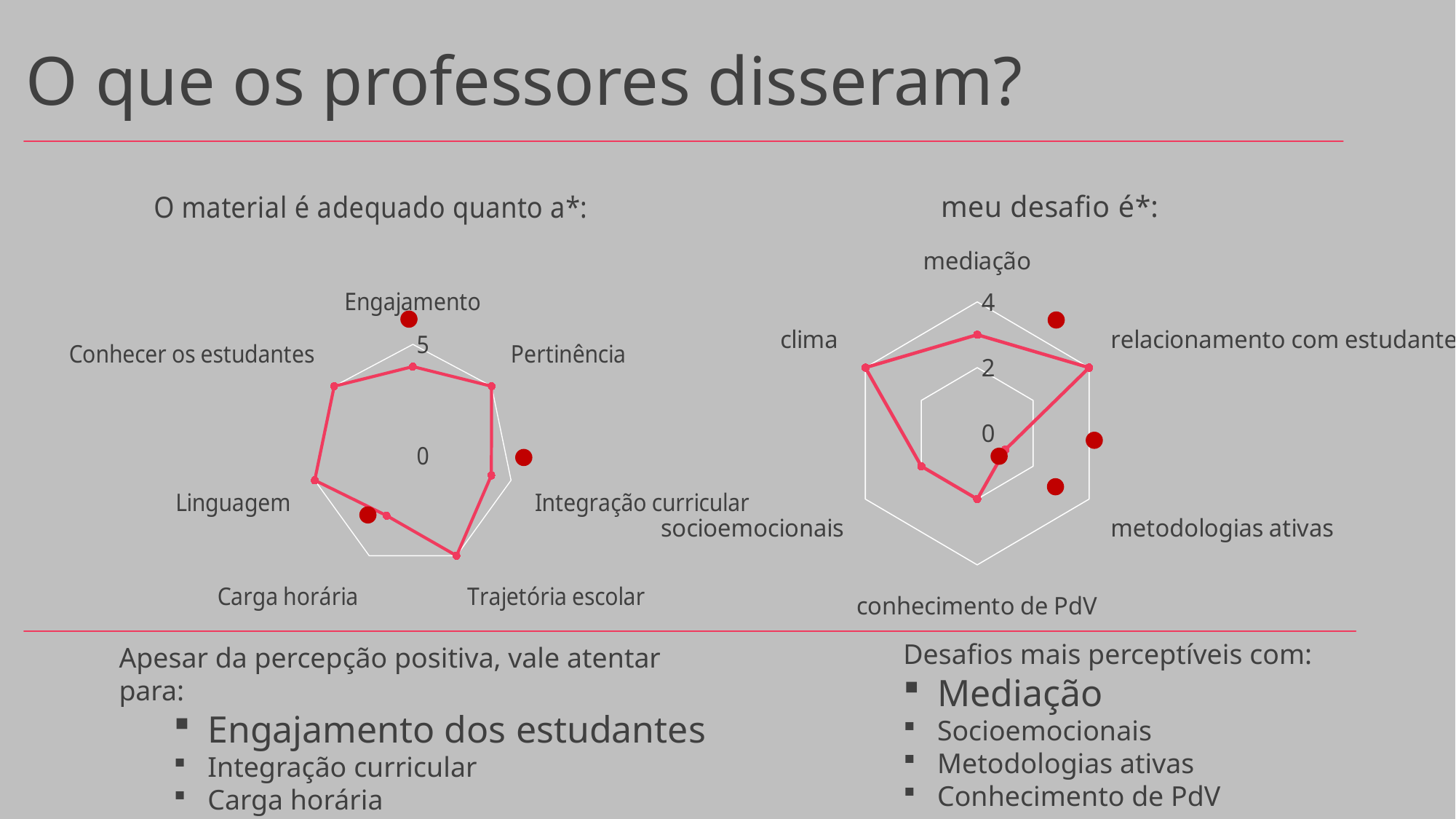
What type of chart is the right chart titled "meu desafio é*:"? radar chart On the right chart "meu desafio é*:", is the value for mediação greater or less than 2? greater How many categories are plotted on the right chart "meu desafio é*:"? 6 On the right chart "meu desafio é*:", which is larger, the value for clima or the value for conhecimento de PdV? clima On the right chart "meu desafio é*:", which category has the lowest value? metodologias ativas What type of chart is the left chart titled "O material é adequado quanto a*:"? radar chart How many categories are plotted on the left chart "O material é adequado quanto a*:"? 7 On the right chart "meu desafio é*:", is the value for clima greater or less than 2? greater What is the maximum value shown on the axis of the left chart "O material é adequado quanto a*:"? 5 On the left chart "O material é adequado quanto a*:", which is larger, the value for Trajetória escolar or the value for Carga horária? Trajetória escolar On the right chart "meu desafio é*:", which category has the highest value? clima and relacionamento com estudantes (tied)